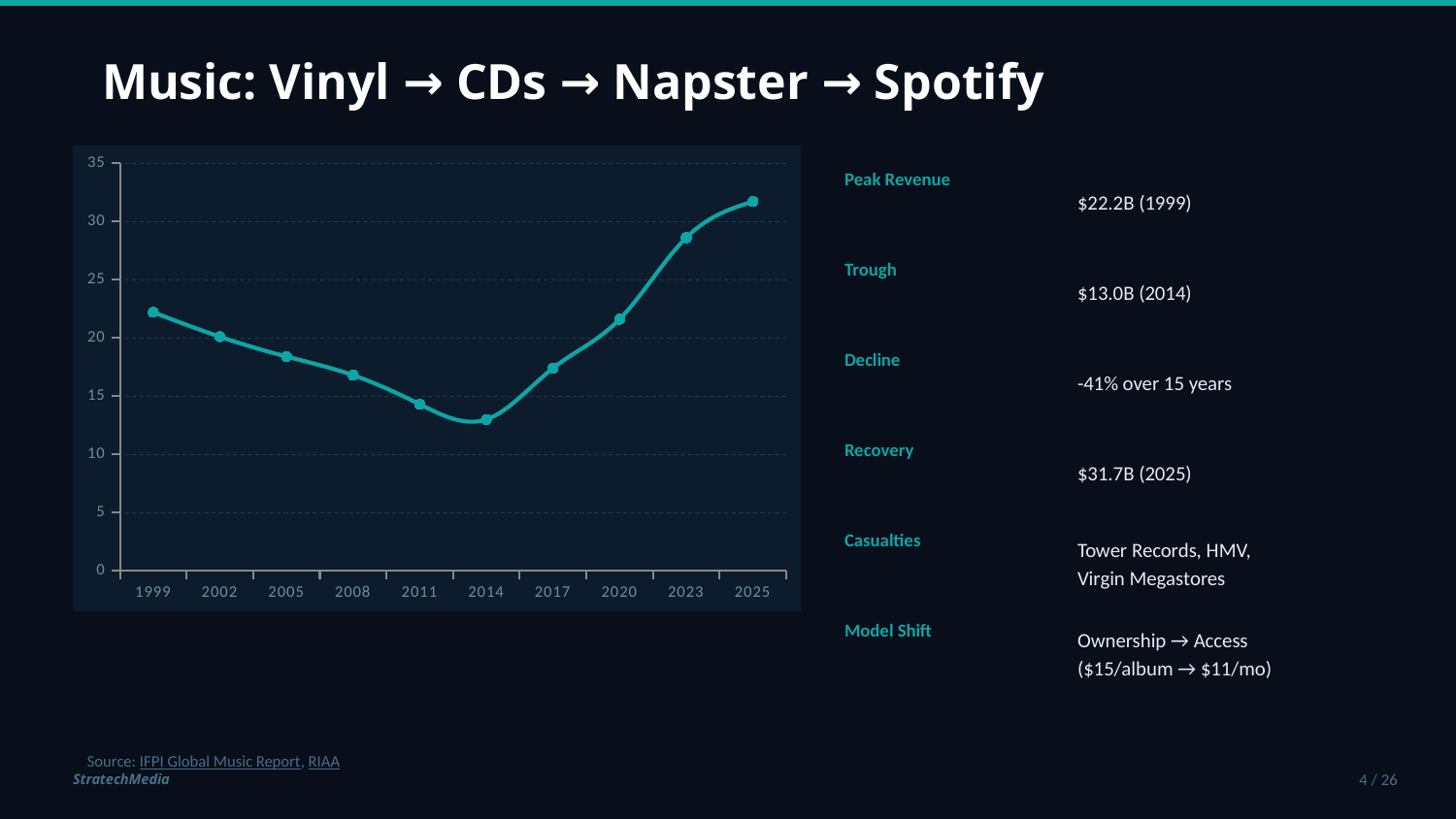
Which year has the lowest value on the line chart? 2014 What is the value for 1999 on the chart? $22.2B Is the value for 2023 greater or less than 25? greater How many data points are plotted on the line chart? 10 What is the value for 2014 on the chart? $13.0B Which year has the highest value on the line chart? 2025 What kind of chart is shown on the slide? line chart Is the value for 2011 greater or less than 15? less How does the line trend from 1999 to 2014? falls What is the difference between the 2025 value and the 1999 value? $9.5B Which is larger, the value for 2008 or the value for 2020? 2020 What is the value for 2025 on the chart? $31.7B